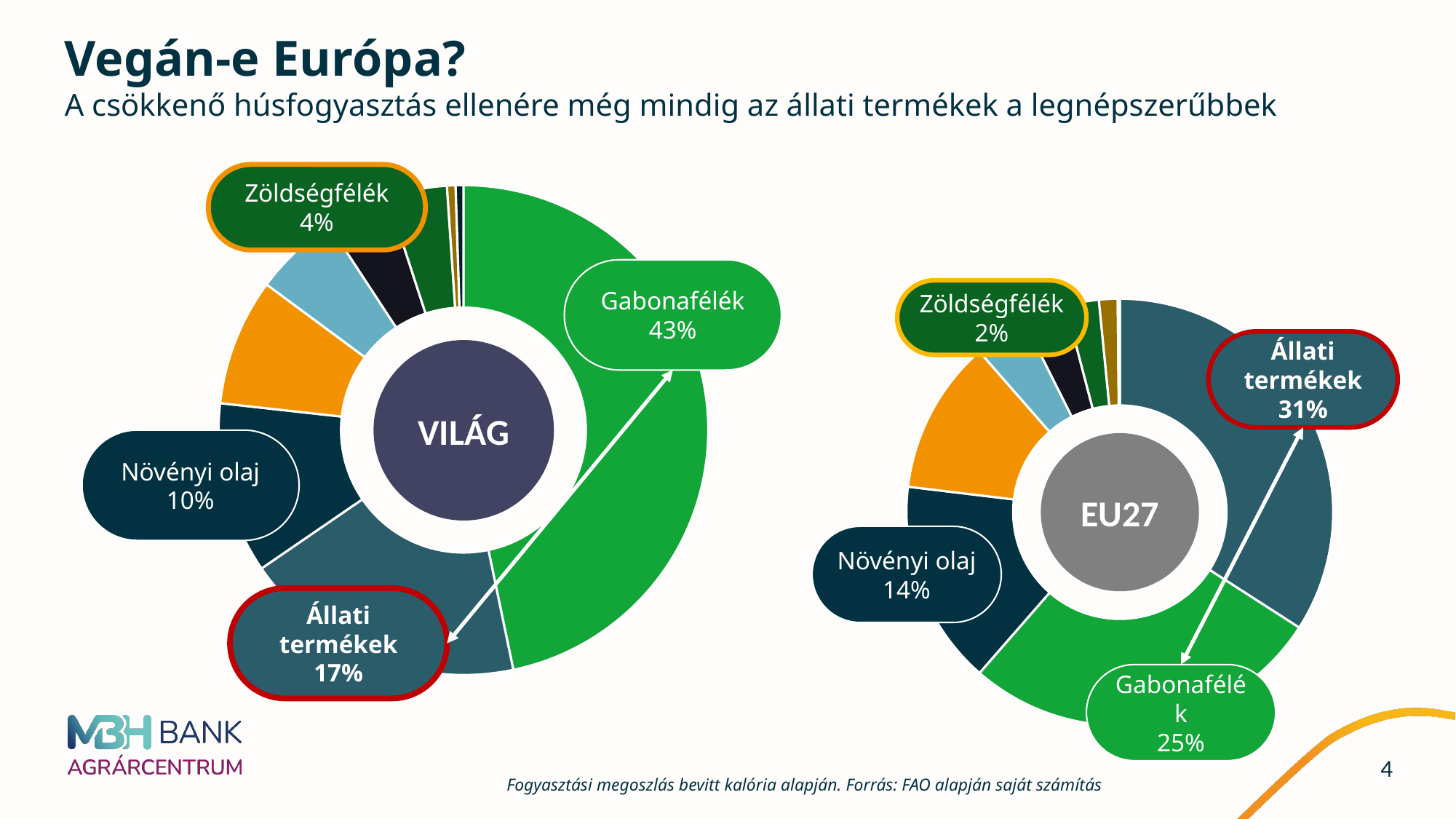
Which is larger: the Növényi olaj share in the EU27 chart or in the VILÁG chart? EU27 In the EU27 chart, what share is labelled for Gabonafélék? 25% What is the difference between the Állati termékek share in the EU27 chart and in the VILÁG chart? 14 percentage points In the VILÁG chart, what share is labelled for Gabonafélék? 43% In the VILÁG chart, which labelled category has the largest share? Gabonafélék In the EU27 chart, which labelled category has the largest share? Állati termékek In the VILÁG chart, what share is labelled for Állati termékek? 17% In the VILÁG chart, what share is labelled for Növényi olaj? 10% What kind of chart is used for VILÁG and EU27 on this slide? Donut (pie) chart In the EU27 chart, what share is labelled for Zöldségfélék? 2% What is the difference between the Gabonafélék share in the VILÁG chart and in the EU27 chart? 18 percentage points In the EU27 chart, what share is labelled for Állati termékek? 31%